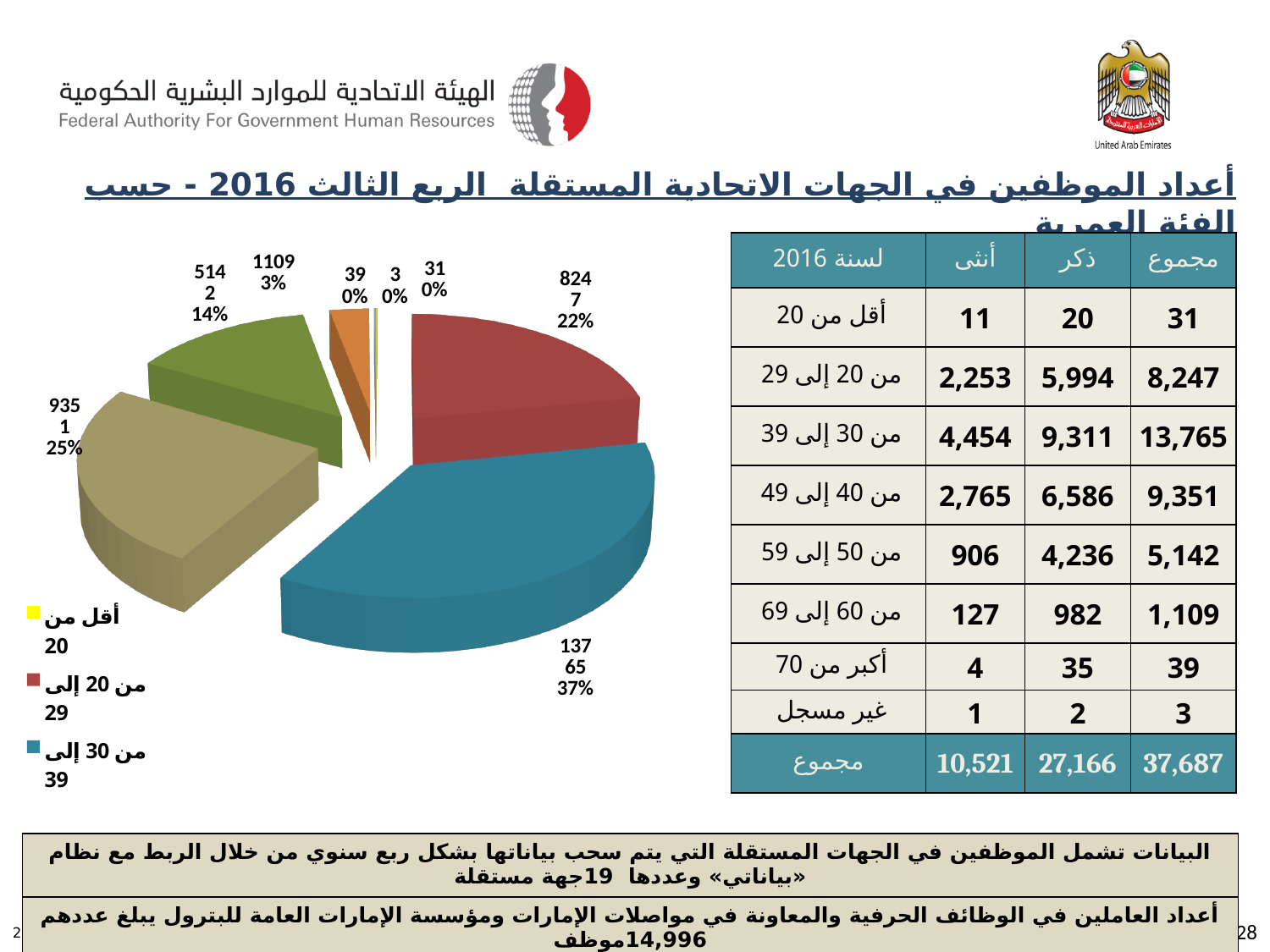
What is the difference in percentage points between the 37% slice and the 22% slice in the pie chart? 15 How many slices are labelled with a percentage in the pie chart? 8 What is the second-largest percentage shown on the pie chart? 25% Which category has the largest slice in the pie chart? من 30 إلى 39 In the pie chart, what share is shown for the slice for من 20 إلى 29 (the red slice)? 22% In the pie chart, what share is shown for the slice for من 30 إلى 39 (the blue slice)? 37% In the pie chart, which slice is larger: من 30 إلى 39 or من 20 إلى 29? من 30 إلى 39 How many legend entries are visible below the pie chart? 3 How many slices in the pie chart are labelled 0%? 3 What kind of chart is shown on the slide? pie chart What colour represents من 30 إلى 39 in the pie chart legend? blue